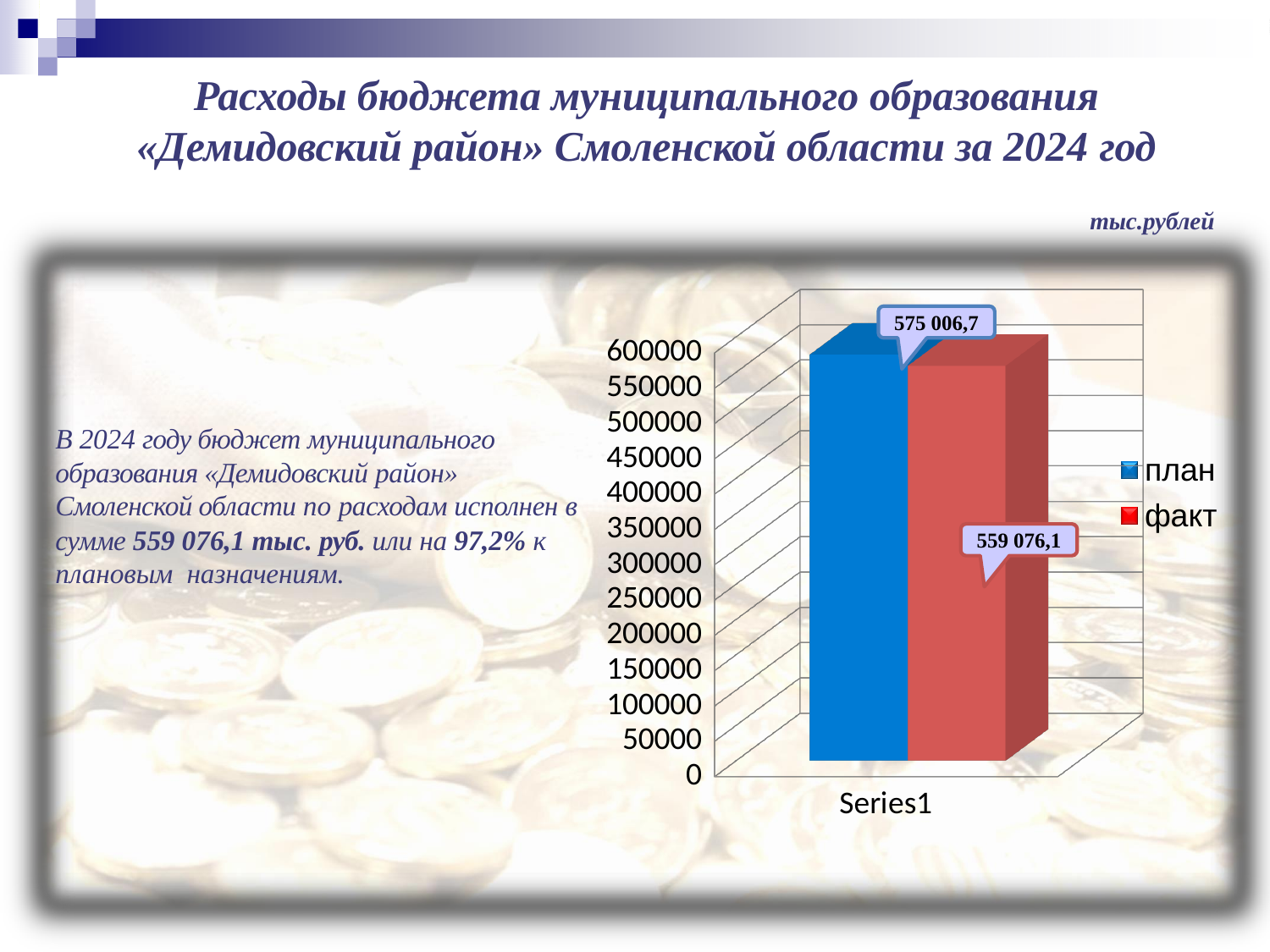
Is the value for факт greater or less than 600000? less How many categories are shown on the x axis of the chart? 1 How many series does the legend list? 2 What is the value of the план (plan) bar? 575 006,7 What is the difference between the план and факт values? 15 930,6 What is the value of the факт (actual) bar? 559 076,1 What kind of chart is shown on the slide? bar chart Which series has the lowest value on the chart? факт Which series has the higher value, план or факт? план What colour is the факт bar? red What unit is indicated for the chart values? тыс.рублей Is the value for план greater or less than 550000? greater